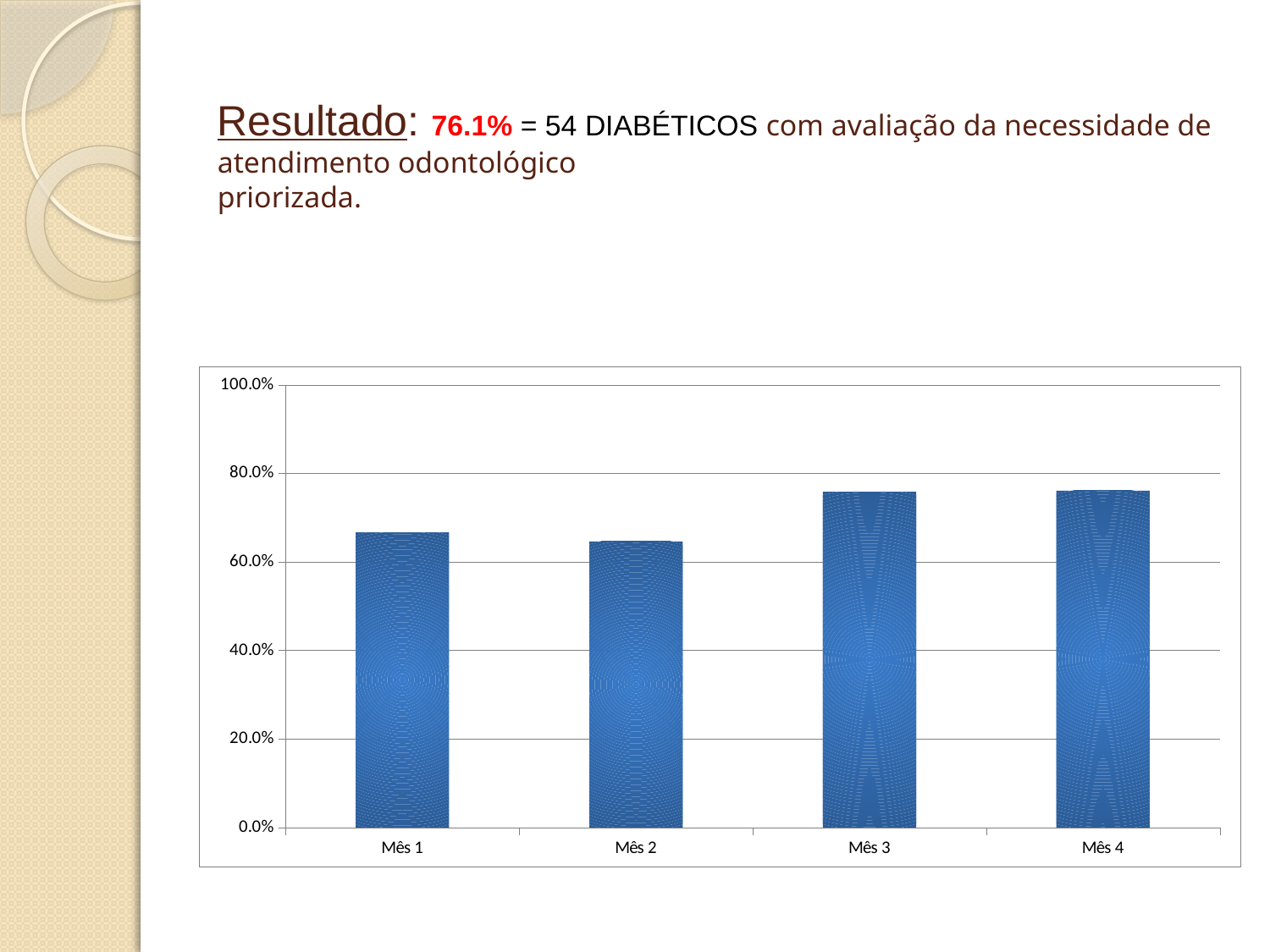
How many categories (months) are plotted on the x axis? 4 Which is larger, the value for Mês 3 or the value for Mês 1? Mês 3 Which is larger, the value for Mês 2 or the value for Mês 4? Mês 4 Is the value for Mês 2 greater or less than 60.0%? greater Is the value for Mês 3 greater or less than 60.0%? greater Is the value for Mês 1 greater or less than 60.0%? greater What is the highest value shown on the y axis? 100.0% What kind of chart is shown on the slide? bar chart What is the label of the first category on the x axis? Mês 1